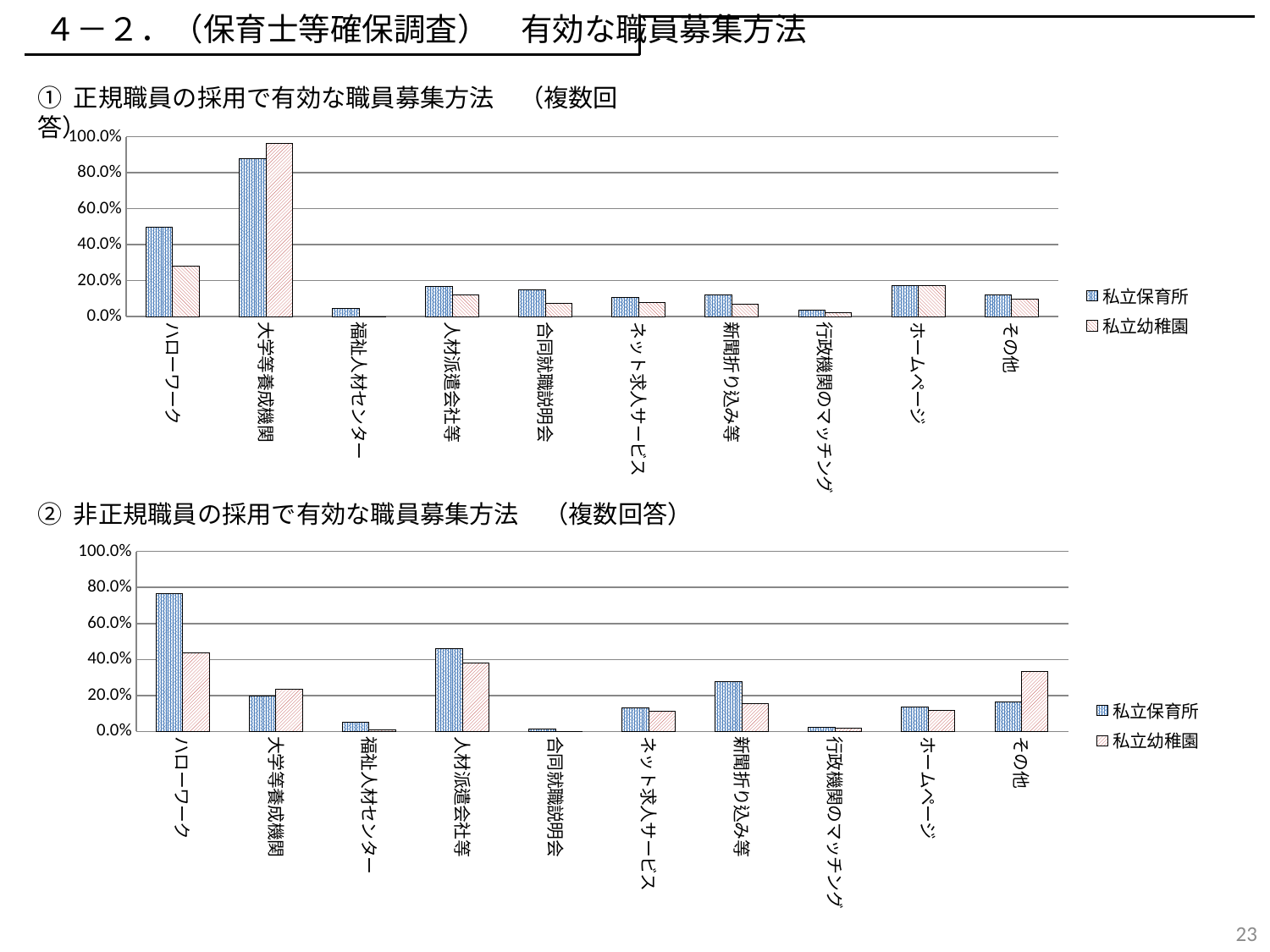
In the top chart (① 正規職員の採用で有効な職員募集方法), which category has the lowest value for 私立幼稚園? 福祉人材センター In the top chart (① 正規職員の採用で有効な職員募集方法), is the value for ハローワーク for 私立保育所 greater or less than 40.0%? greater In the bottom chart (② 非正規職員の採用で有効な職員募集方法), which category has the highest value for 私立保育所? ハローワーク In the bottom chart (② 非正規職員の採用で有効な職員募集方法), is the value for ハローワーク for 私立保育所 greater or less than 60.0%? greater In the top chart (① 正規職員の採用で有効な職員募集方法), which category has the highest value for 私立保育所? 大学等養成機関 In the bottom chart (② 非正規職員の採用で有効な職員募集方法), for その他, which series has the larger value, 私立保育所 or 私立幼稚園? 私立幼稚園 In the bottom chart (② 非正規職員の採用で有効な職員募集方法), is the value for 新聞折り込み等 for 私立保育所 greater or less than 20.0%? greater In the top chart (① 正規職員の採用で有効な職員募集方法), how many series does the legend list? 2 In the top chart (① 正規職員の採用で有効な職員募集方法), for 大学等養成機関, which series has the larger value, 私立保育所 or 私立幼稚園? 私立幼稚園 In the top chart (① 正規職員の採用で有効な職員募集方法), for ハローワーク, which series has the larger value, 私立保育所 or 私立幼稚園? 私立保育所 What kind of chart is the top chart (① 正規職員の採用で有効な職員募集方法)? bar chart In the top chart (① 正規職員の採用で有効な職員募集方法), how many categories are shown on the x axis? 10